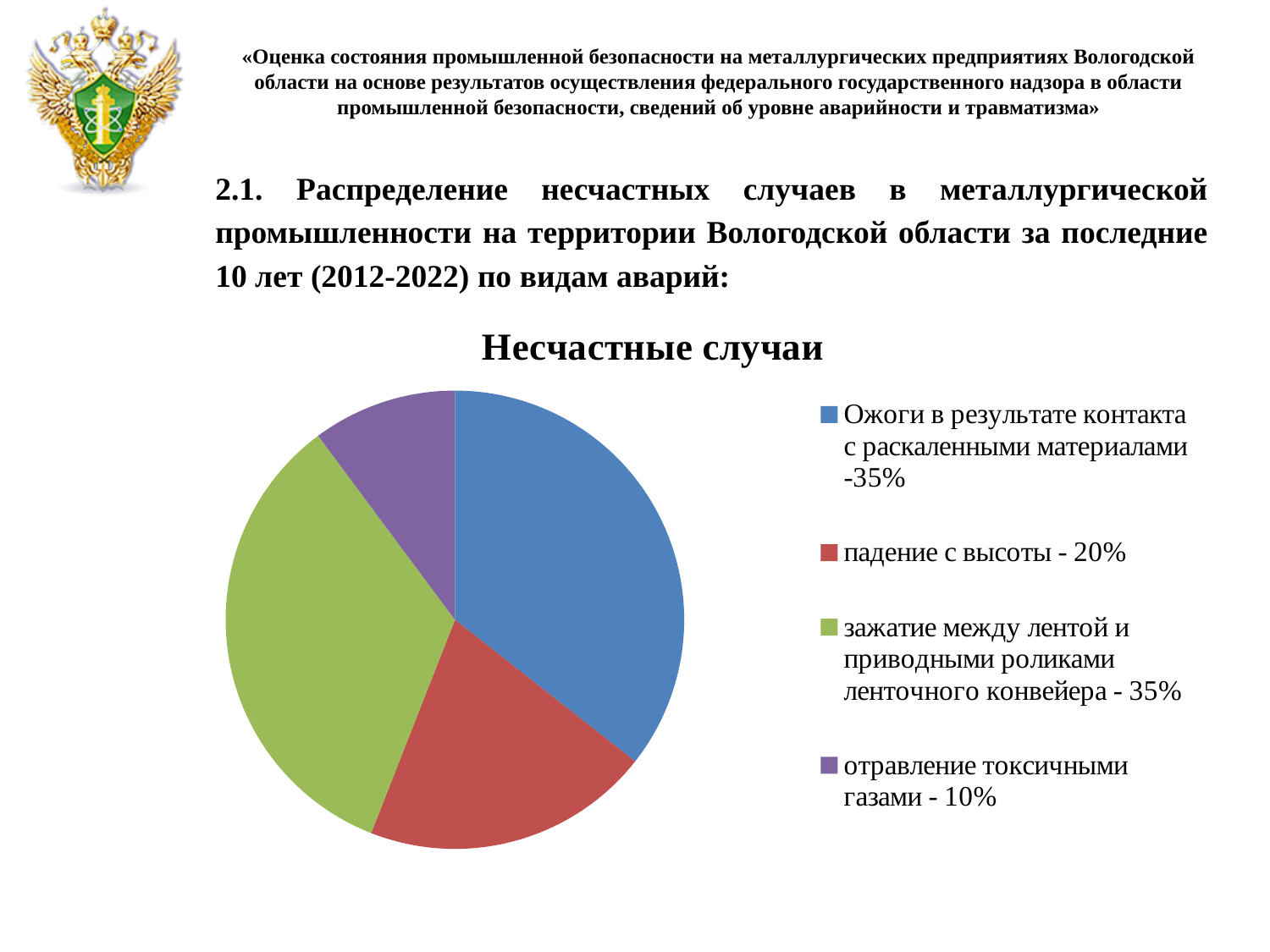
How many slices does the pie chart have? 4 What is the title of the chart? Несчастные случаи What is the difference in percentage points between the share for ожоги в результате контакта с раскаленными материалами and the share for падение с высоты? 15 What share of accidents is attributed to падение с высоты? 20% Which is larger: the share for падение с высоты or the share for отравление токсичными газами? падение с высоты What share of accidents is attributed to ожоги в результате контакта с раскаленными материалами? 35% What share of accidents is attributed to отравление токсичными газами? 10% What kind of chart is shown on the slide? pie chart What is the difference in percentage points between the share for падение с высоты and the share for отравление токсичными газами? 10 What share of accidents is attributed to зажатие между лентой и приводными роликами ленточного конвейера? 35% What colour is the slice for падение с высоты? red Which category has the smallest share of the pie? отравление токсичными газами